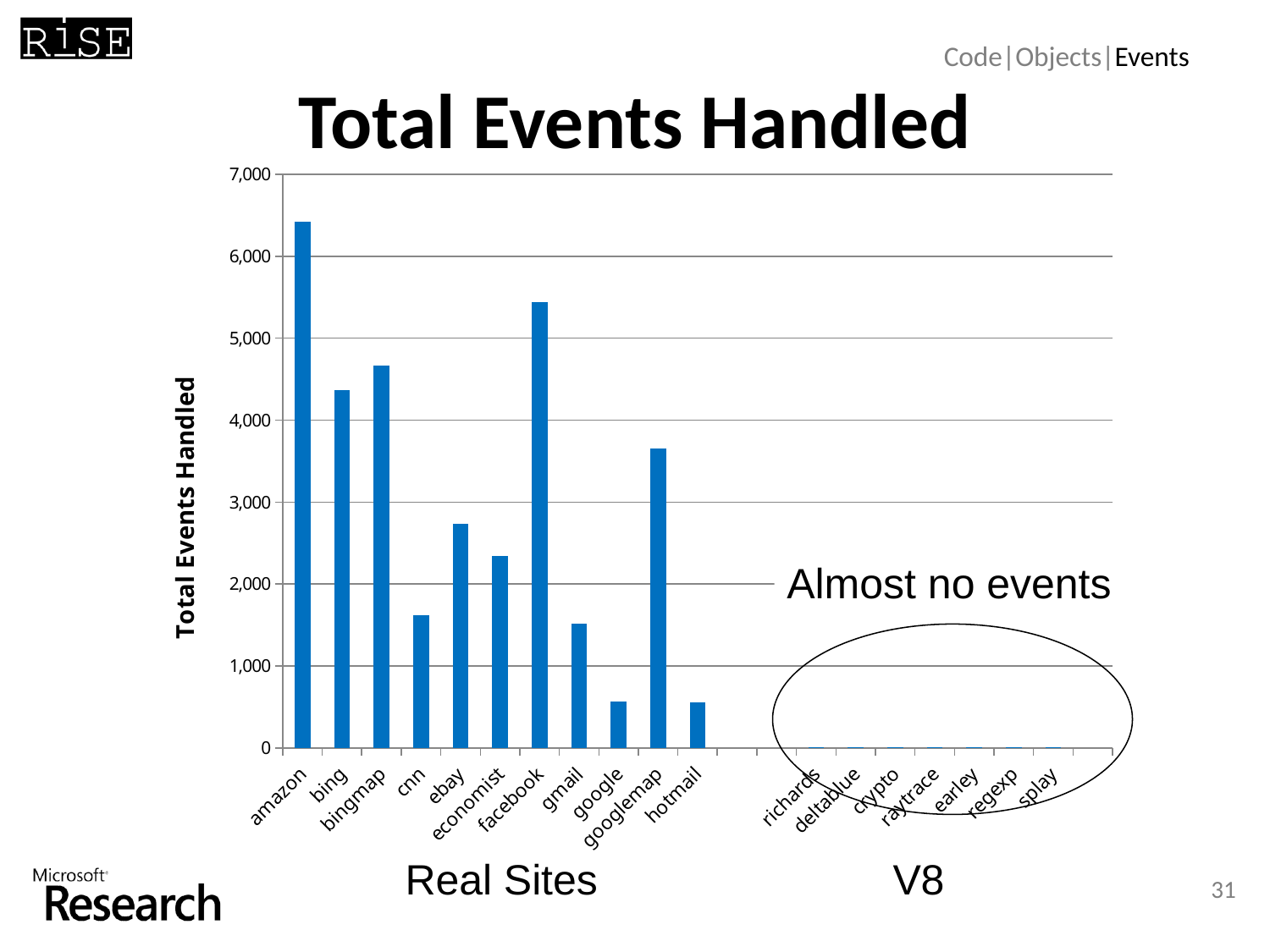
How many V8 categories are labeled on the x axis? 7 Which has a larger value, ebay or economist? ebay Is the value for facebook greater or less than 5,000? greater How many Real Sites categories are labeled on the x axis? 11 Which has a larger value, bingmap or bing? bingmap Is the value for googlemap greater or less than 3,000? greater Is the value for cnn greater or less than 2,000? less Which category has the highest value in the chart? amazon What kind of chart is shown on the slide? bar chart What is the title of the chart? Total Events Handled